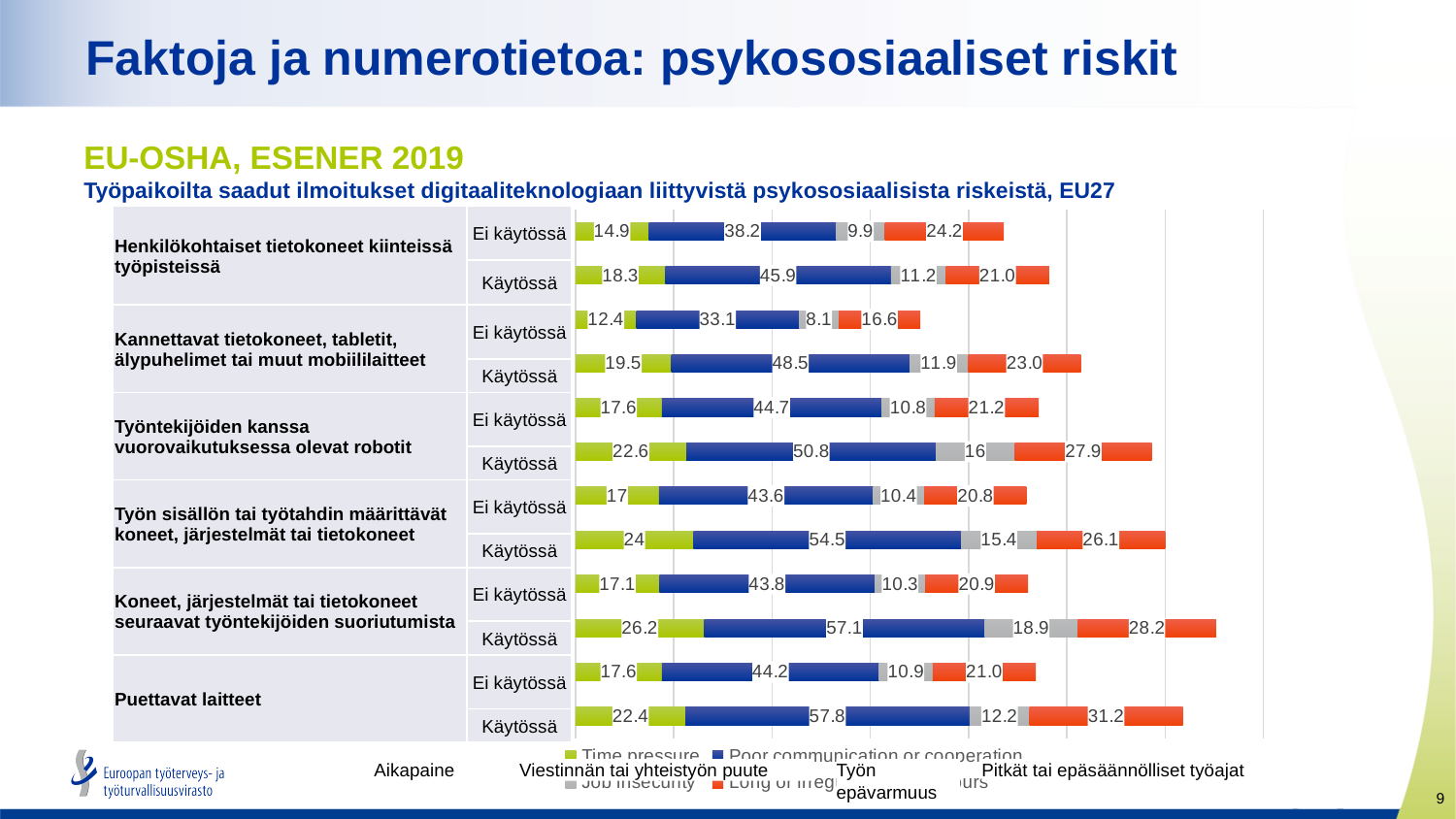
Which bar has the lowest value for the blue (Viestinnän tai yhteistyön puute) segment? Kannettavat tietokoneet, tabletit, älypuhelimet tai muut mobiililaitteet, Ei käytössä Which bar has the highest value for the green (Aikapaine) segment? Koneet, järjestelmät tai tietokoneet seuraavat työntekijöiden suoriutumista, Käytössä What is the value of the green (Aikapaine / time pressure) segment for 'Puettavat laitteet', Käytössä? 22.4 What is the value of the grey (Työn epävarmuus) segment for 'Työntekijöiden kanssa vuorovaikutuksessa olevat robotit', Käytössä? 16 What is the value of the blue (Viestinnän tai yhteistyön puute) segment for 'Kannettavat tietokoneet, tabletit, älypuhelimet tai muut mobiililaitteet', Ei käytössä? 33.1 What is the difference between the blue segment values for 'Puettavat laitteet' Käytössä and Ei käytössä? 13.6 What is the value of the orange (Pitkät tai epäsäännölliset työajat) segment for 'Henkilökohtaiset tietokoneet kiinteissä työpisteissä', Ei käytössä? 24.2 How many series does the legend list? 4 Which is larger: the orange segment for 'Puettavat laitteet' Käytössä or for 'Koneet, järjestelmät tai tietokoneet seuraavat työntekijöiden suoriutumista' Käytössä? Puettavat laitteet, Käytössä What type of chart is shown on the slide? stacked bar chart How many bars are plotted in the chart? 12 What is the total of the stacked bar for 'Puettavat laitteet', Käytössä? 123.6